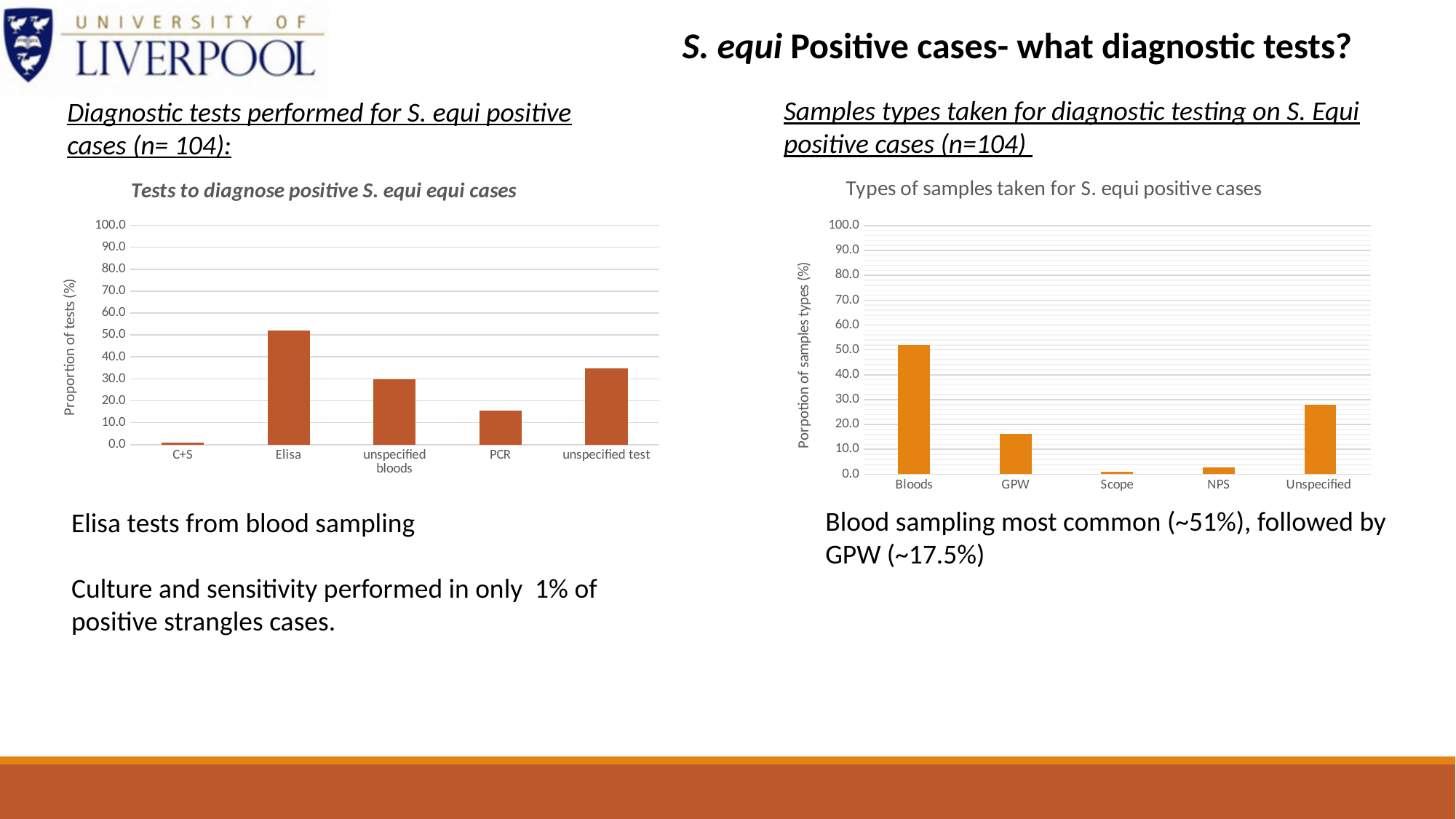
What type of chart is 'Tests to diagnose positive S. equi equi cases'? bar chart In the chart titled 'Types of samples taken for S. equi positive cases', which sample type has the lowest proportion? Scope In the chart titled 'Tests to diagnose positive S. equi equi cases', is the value for PCR greater or less than 20.0? less How many test categories are shown in the chart titled 'Tests to diagnose positive S. equi equi cases'? 5 In the chart titled 'Tests to diagnose positive S. equi equi cases', is the value for Elisa greater or less than 50.0? greater In the chart titled 'Types of samples taken for S. equi positive cases', which sample type has the highest proportion? Bloods In the chart titled 'Types of samples taken for S. equi positive cases', which is larger, GPW or NPS? GPW In the chart titled 'Tests to diagnose positive S. equi equi cases', which is larger, unspecified bloods or unspecified test? unspecified test What is the y-axis label of the chart titled 'Types of samples taken for S. equi positive cases'? Porpotion of samples types (%) In the chart titled 'Types of samples taken for S. equi positive cases', is the value for Unspecified greater or less than 20.0? greater In the chart titled 'Tests to diagnose positive S. equi equi cases', which test has the highest proportion? Elisa In the chart titled 'Tests to diagnose positive S. equi equi cases', which test has the lowest proportion? C+S